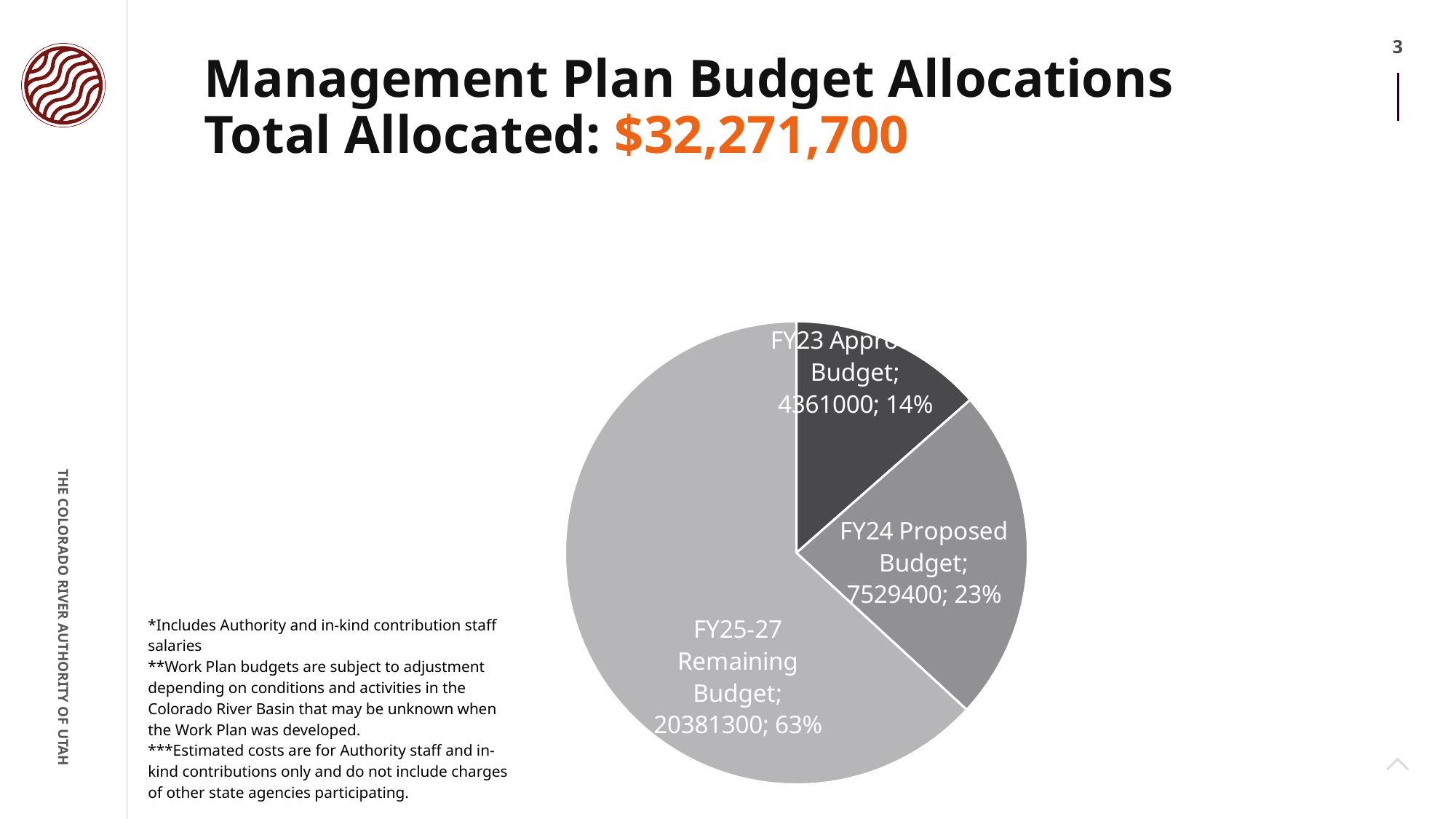
What value is shown for the FY25-27 Remaining Budget slice? 20381300 What kind of chart is shown on the slide? pie chart What share of the pie does the FY25-27 Remaining Budget slice represent? 63% What value is shown for the FY23 Budget slice? 4361000 What share of the pie does the FY23 Budget slice represent? 14% Which slice of the pie chart is the largest? FY25-27 Remaining Budget What share of the pie does the FY24 Proposed Budget slice represent? 23% What value is shown for the FY24 Proposed Budget slice? 7529400 What is the difference between the FY24 Proposed Budget value and the FY23 Budget value? 3168400 How many slices does the pie chart have? 3 Which slice of the pie chart is the smallest? FY23 Approved Budget What total allocated amount is stated in the slide title? $32,271,700